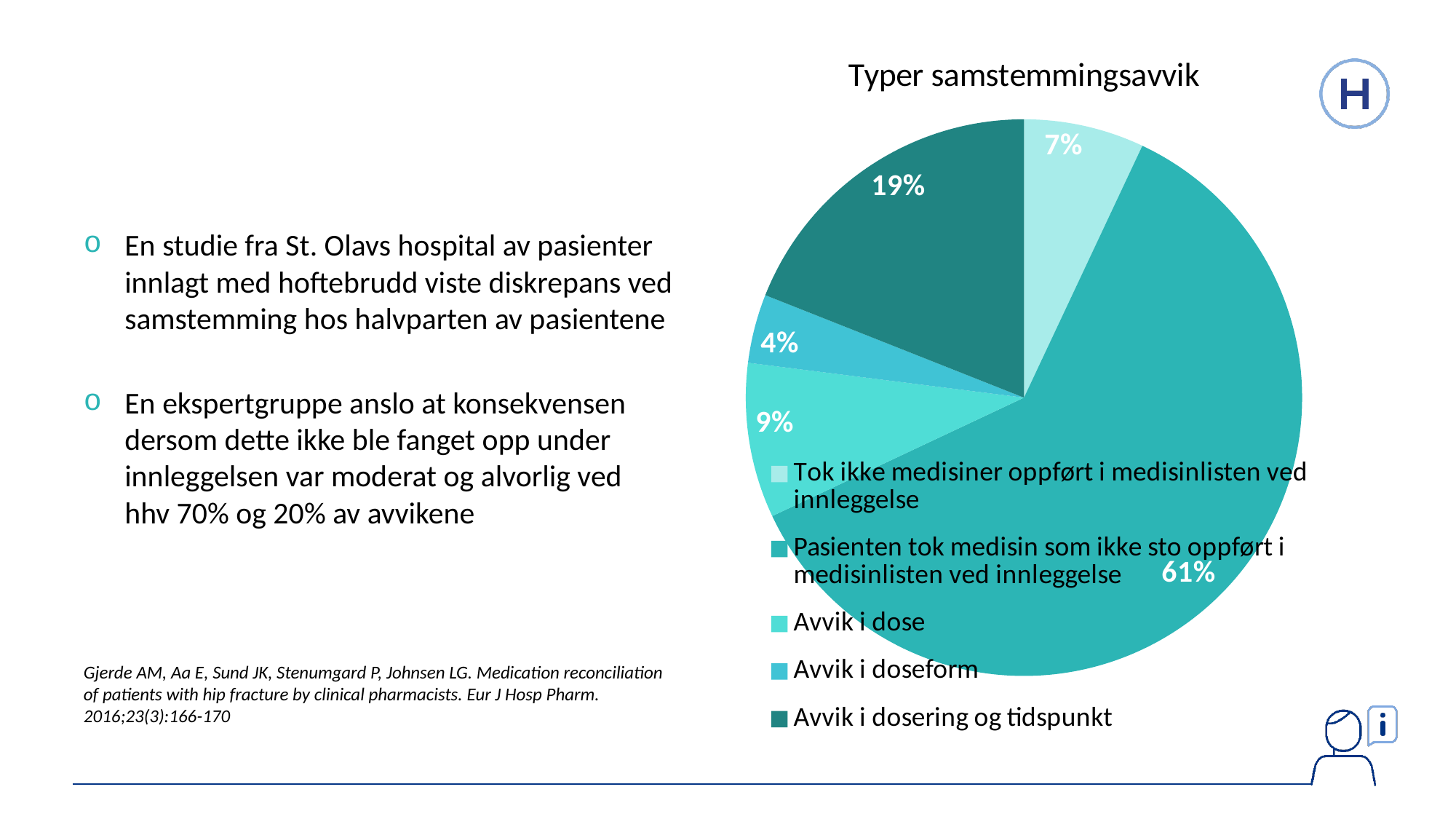
What share of the pie is 'Tok ikke medisiner oppført i medisinlisten ved innleggelse'? 7% What is the title of the chart? Typer samstemmingsavvik Which category has the smallest slice of the pie? Avvik i doseform What is the difference in percentage points between 'Avvik i dosering og tidspunkt' and 'Avvik i dose'? 10 What kind of chart is shown on the slide? pie chart What share of the pie is 'Pasienten tok medisin som ikke sto oppført i medisinlisten ved innleggelse'? 61% What share of the pie is 'Avvik i dose'? 9% Which is larger, the slice for 'Avvik i dose' or the slice for 'Tok ikke medisiner oppført i medisinlisten ved innleggelse'? Avvik i dose Which category has the largest slice of the pie? Pasienten tok medisin som ikke sto oppført i medisinlisten ved innleggelse How many slices does the pie chart have? 5